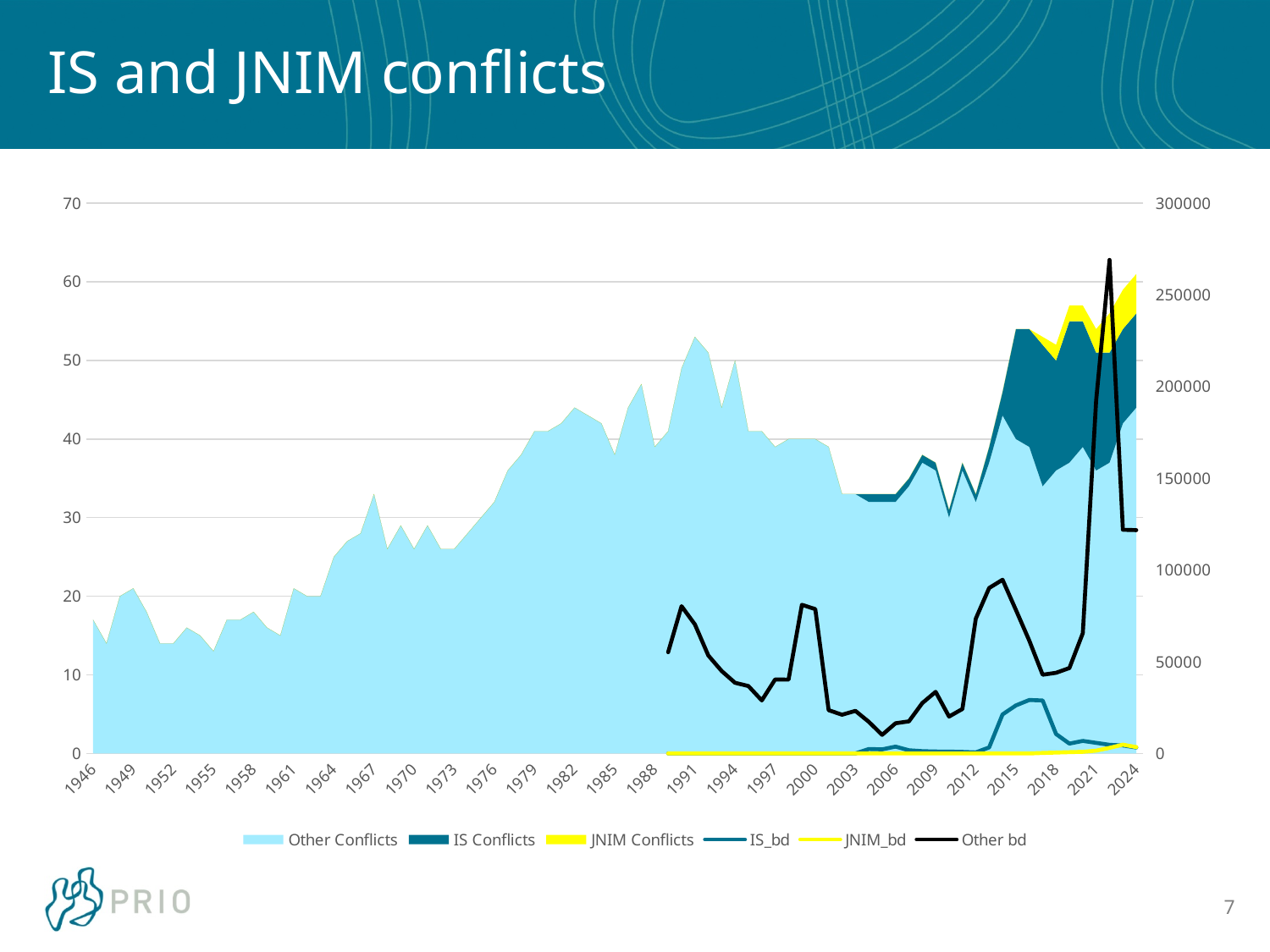
How many year labels are shown on the x axis? 27 How many series does the legend list? 6 Is the value of Other Conflicts in 1946 greater or less than 10 on the left axis? greater Is the peak of the Other bd line around 2021 greater or less than 250000 on the right axis? greater What is the title of the slide containing the chart? IS and JNIM conflicts Which series is drawn as the black line? Other bd Does the Other bd line rise or fall from 2018 to 2021? rise What kind of chart is shown on the slide? A combined stacked area and line chart Is the peak of the IS_bd line around 2017 greater or less than 50000 on the right axis? less Does the Other Conflicts area generally rise or fall from 1946 to 1991? rise